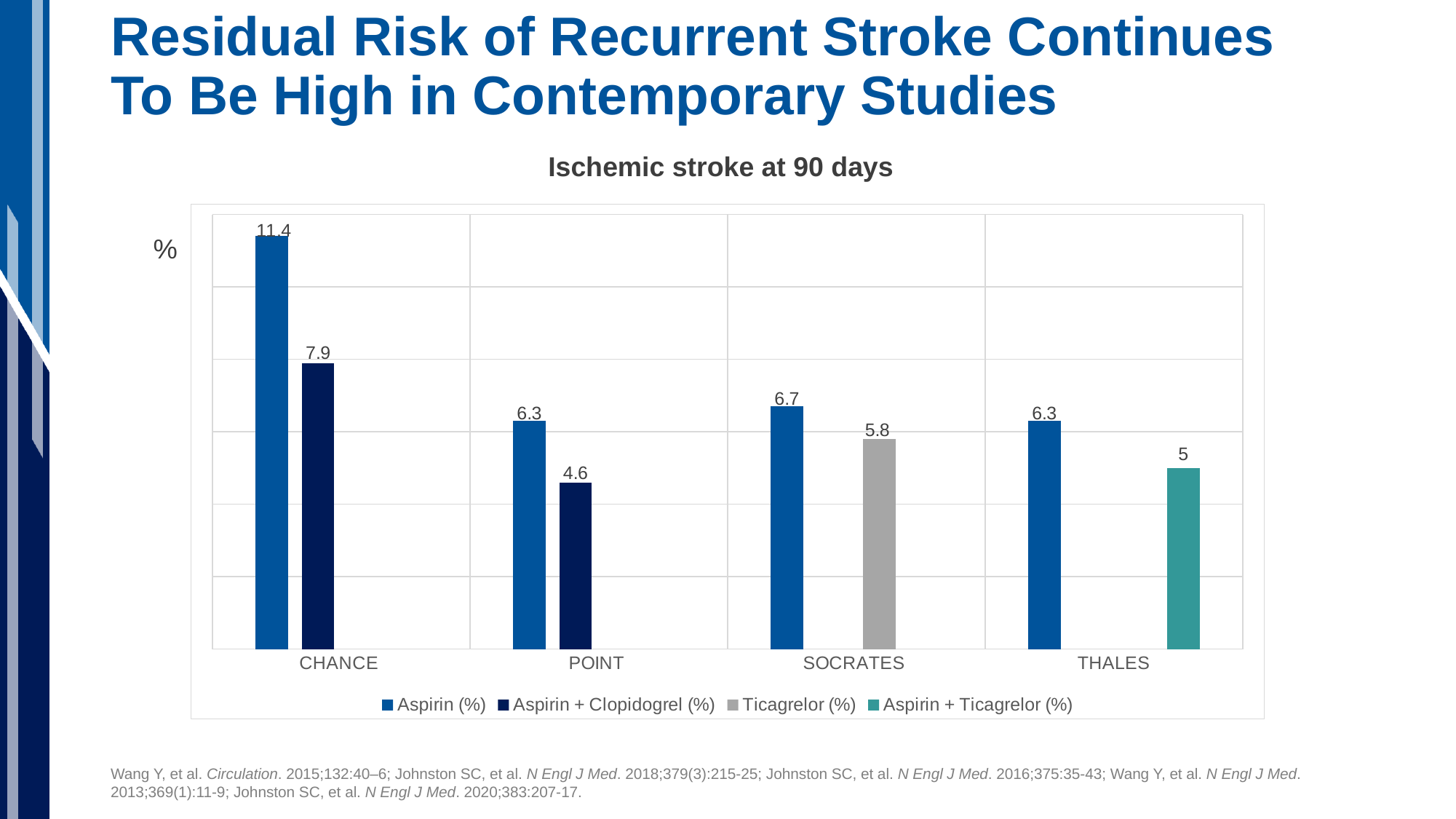
Which study has the highest Aspirin (%) value? CHANCE Which bar shows the lowest value on the chart? Aspirin + Clopidogrel (%) for POINT What is the Ticagrelor (%) value for SOCRATES? 5.8 What is the Aspirin + Clopidogrel (%) value for POINT? 4.6 Which is larger for SOCRATES: Aspirin (%) or Ticagrelor (%)? Aspirin (%) What is the Aspirin (%) value for CHANCE? 11.4 How many studies are shown on the x axis? 4 What is the Aspirin + Ticagrelor (%) value for THALES? 5 How many series does the legend list? 4 What is the title of the chart? Ischemic stroke at 90 days What is the difference between the Aspirin (%) and Aspirin + Clopidogrel (%) values for CHANCE? 3.5 What kind of chart is shown? Bar chart